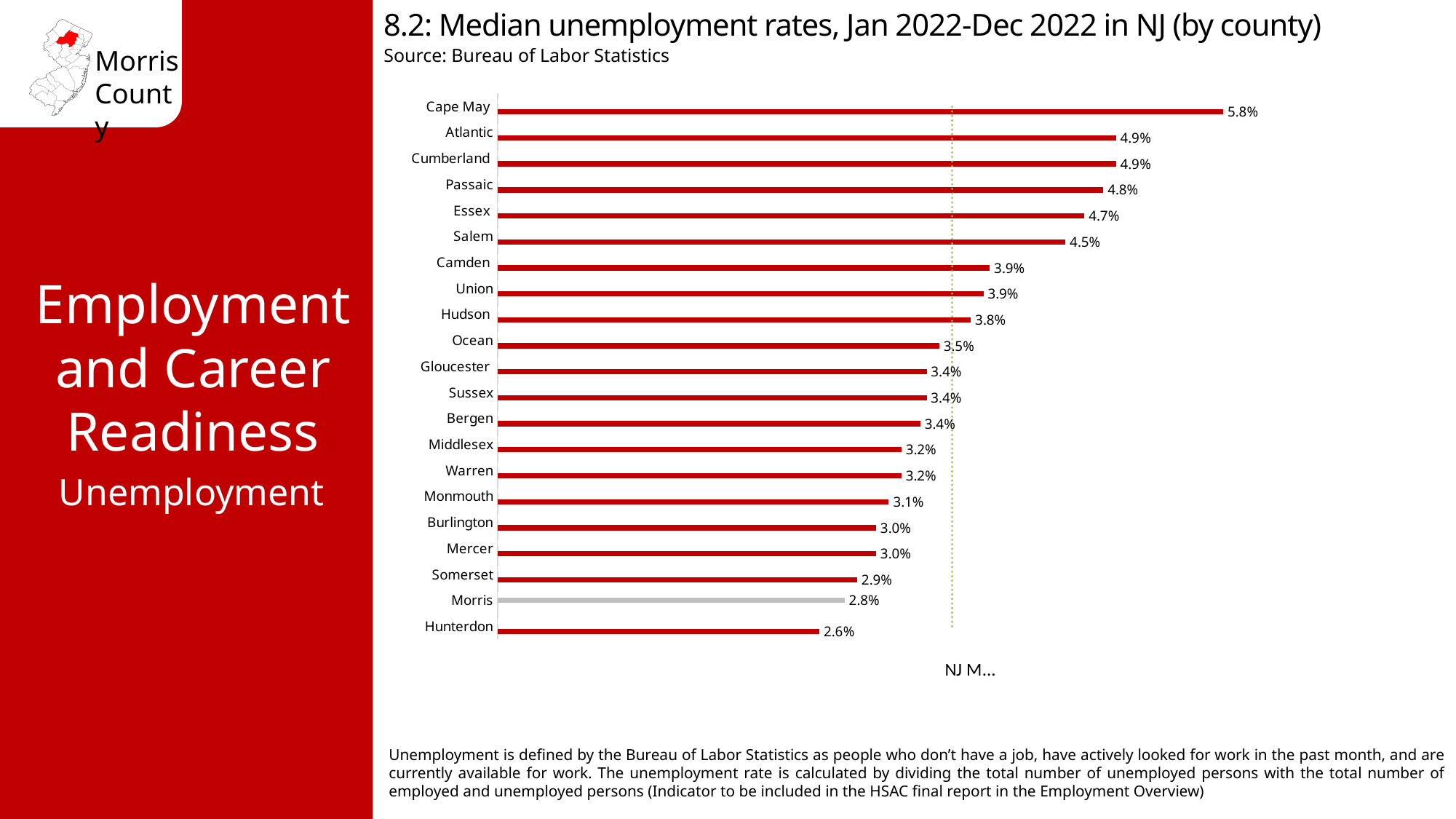
What is the median unemployment rate for Hudson? 3.8% What type of chart is used on this slide? Bar chart Which county has the highest median unemployment rate? Cape May Which county's bar is shown in grey instead of red? Morris What is the difference between the median unemployment rates of Morris and Somerset? 0.1% Which has a higher median unemployment rate, Essex or Camden? Essex What is the median unemployment rate for Morris County? 2.8% Which county has the lowest median unemployment rate? Hunterdon What is the median unemployment rate for Cape May? 5.8% What is the difference between the median unemployment rates of Cape May and Hunterdon? 3.2% Which has a higher median unemployment rate, Monmouth or Salem? Salem How many counties are shown in the chart? 21